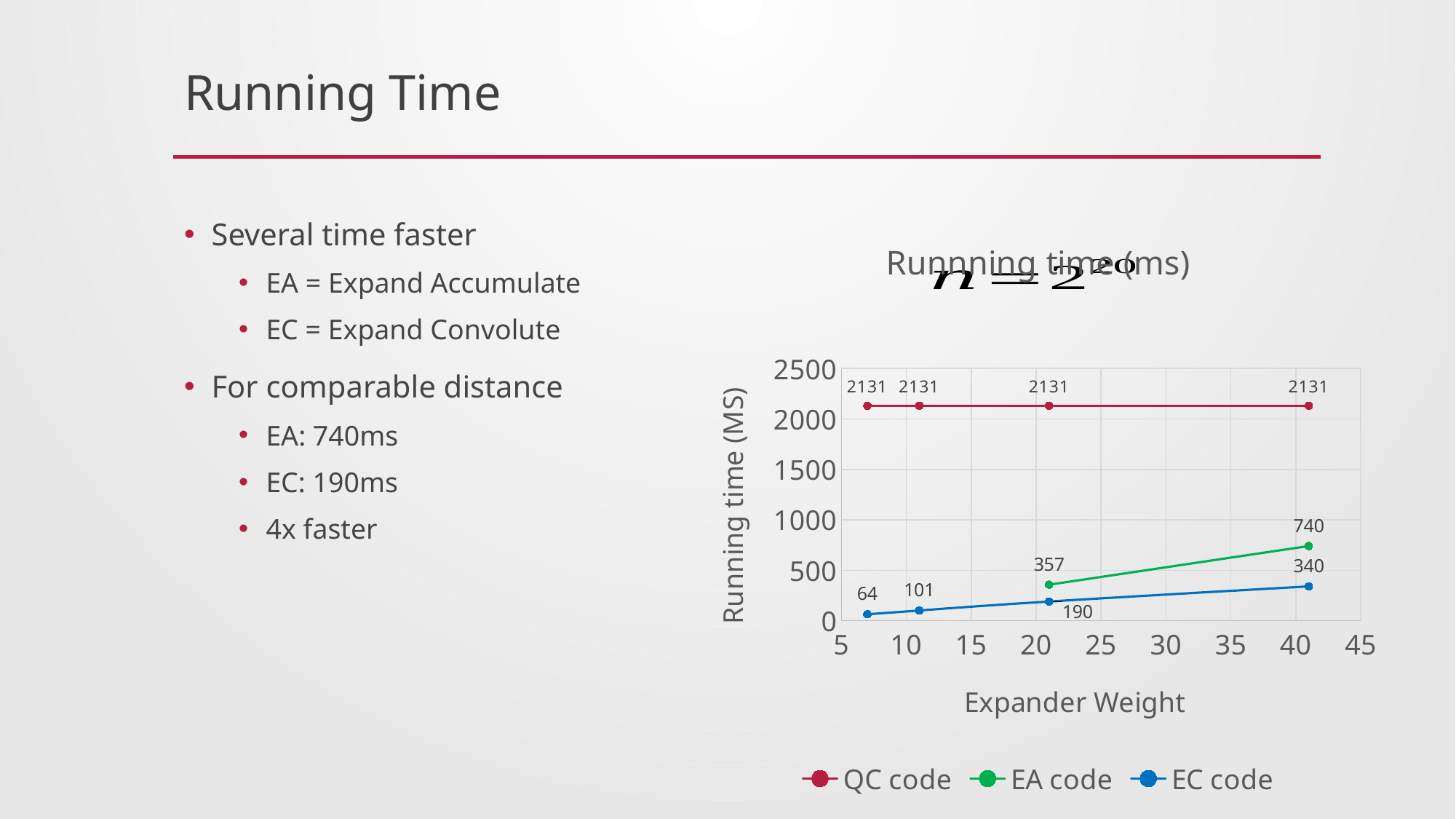
What type of chart is shown on the slide? line chart Does the EC code running time rise or fall as expander weight increases? rise What is the running time of the QC code at every plotted expander weight? 2131 What is the difference between the EA code and EC code running times at the rightmost plotted point? 400 What is the running time of the EC code at its first (leftmost) plotted point? 64 How many data points are plotted for the EC code series? 4 What is the running time of the EC code at its last (rightmost) plotted point? 340 What is the running time of the EA code at its first (leftmost) plotted point? 357 Which series has the lowest running time at the rightmost expander weight? EC code What is the running time of the EA code at its last (rightmost) plotted point? 740 Which series has the highest running time at the rightmost expander weight? QC code How many series does the legend list? 3